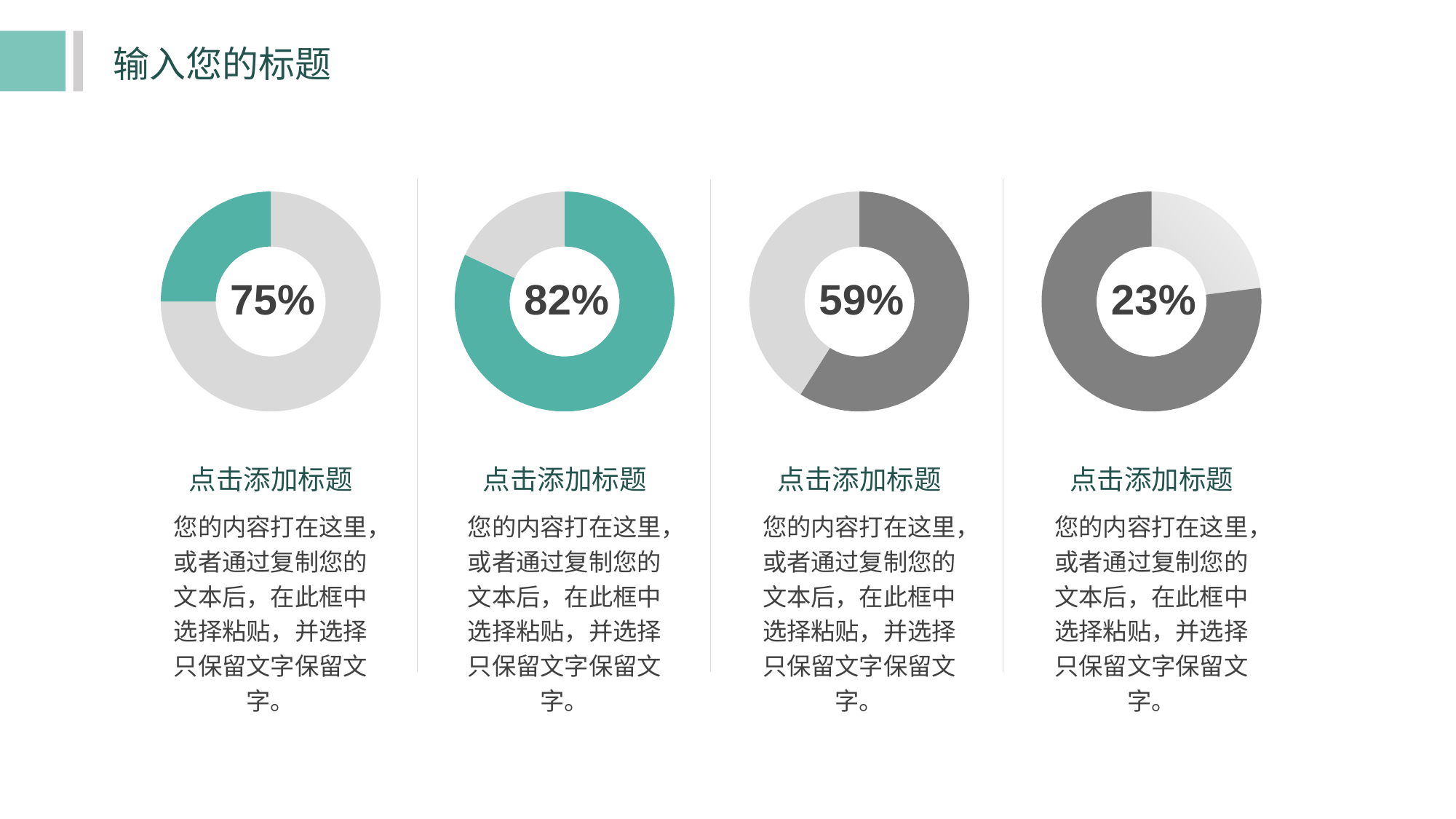
What percentage is shown in the centre of the leftmost donut chart? 75% What colour is the filled segment of the second donut chart from the left? Teal (green) Which of the four donut charts shows the highest percentage? The second from the left (82%) What percentage is shown in the centre of the rightmost donut chart? 23% Which of the four donut charts shows the lowest percentage? The rightmost (23%) What is the difference between the percentage in the second donut chart (82%) and the leftmost donut chart (75%)? 7% What kind of chart is used on this slide? Donut chart What percentage is shown in the centre of the second donut chart from the left? 82% What percentage is shown in the centre of the third donut chart from the left? 59% What is the difference between the percentage in the third donut chart (59%) and the rightmost donut chart (23%)? 36% How many donut charts are on the slide? 4 Which is larger: the percentage in the leftmost donut chart or the percentage in the third donut chart from the left? The leftmost (75%)